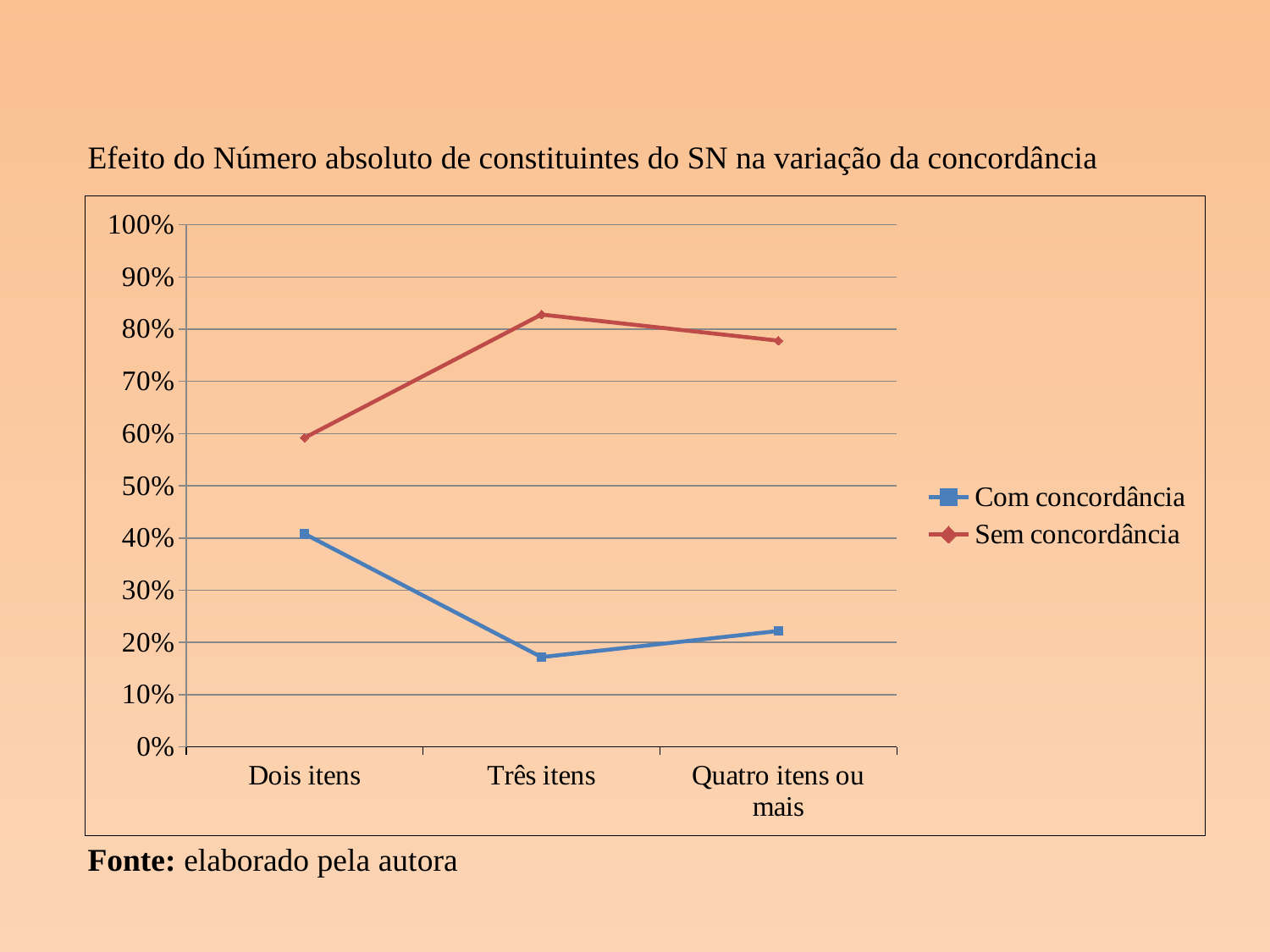
Which series has the larger value for Dois itens, Com concordância or Sem concordância? Sem concordância How many series does the legend list? 2 How many categories are shown on the x axis? 3 For which category is the Sem concordância value highest? Três itens Is the Sem concordância value for Quatro itens ou mais greater or less than 70%? greater For which category is the Com concordância value lowest? Três itens Does the Com concordância line rise or fall from Dois itens to Três itens? fall For which category is the Com concordância value highest? Dois itens Is the Sem concordância value for Dois itens greater or less than 50%? greater What kind of chart is shown on the slide? line chart What is the title of the chart? Efeito do Número absoluto de constituintes do SN na variação da concordância Is the Com concordância value for Três itens greater or less than 20%? less